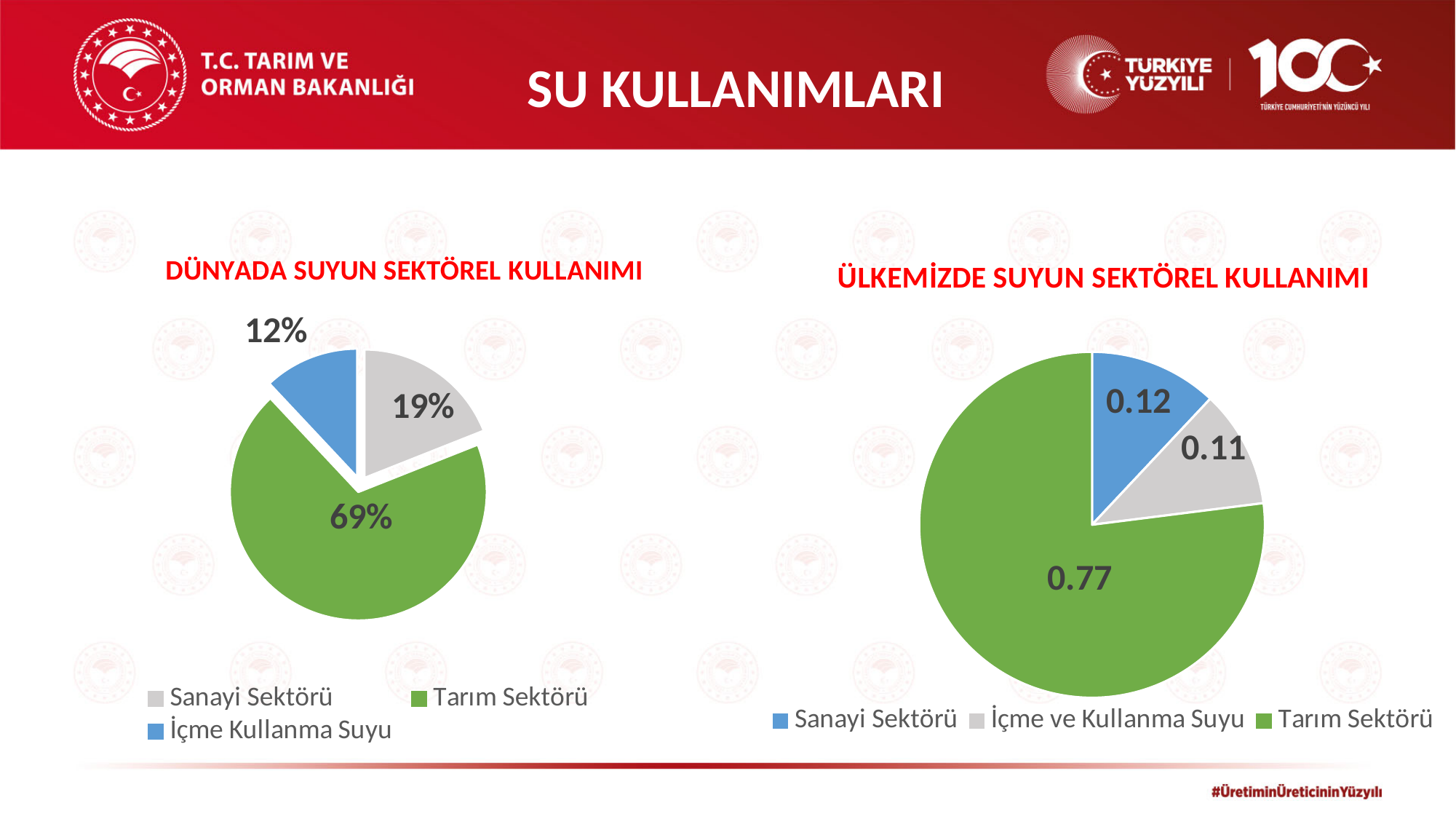
In the chart titled 'DÜNYADA SUYUN SEKTÖREL KULLANIMI', what is the difference between the Tarım Sektörü and Sanayi Sektörü values? 50% In the chart titled 'ÜLKEMİZDE SUYUN SEKTÖREL KULLANIMI', what is the value for Sanayi Sektörü? 0.12 In the chart titled 'DÜNYADA SUYUN SEKTÖREL KULLANIMI', what is the value for Sanayi Sektörü? 19% In the chart titled 'ÜLKEMİZDE SUYUN SEKTÖREL KULLANIMI', what is the value for Tarım Sektörü? 0.77 What type of chart is the chart titled 'ÜLKEMİZDE SUYUN SEKTÖREL KULLANIMI'? Pie chart In the chart titled 'ÜLKEMİZDE SUYUN SEKTÖREL KULLANIMI', which category has the largest share? Tarım Sektörü In the chart titled 'DÜNYADA SUYUN SEKTÖREL KULLANIMI', what is the value for Tarım Sektörü? 69% In the chart titled 'DÜNYADA SUYUN SEKTÖREL KULLANIMI', which category has the smallest share? İçme Kullanma Suyu In the chart titled 'DÜNYADA SUYUN SEKTÖREL KULLANIMI', what is the value for İçme Kullanma Suyu? 12% How many categories does the legend of the chart titled 'ÜLKEMİZDE SUYUN SEKTÖREL KULLANIMI' list? 3 In the chart titled 'DÜNYADA SUYUN SEKTÖREL KULLANIMI', which category has the largest share? Tarım Sektörü In the chart titled 'ÜLKEMİZDE SUYUN SEKTÖREL KULLANIMI', what is the value for İçme ve Kullanma Suyu? 0.11